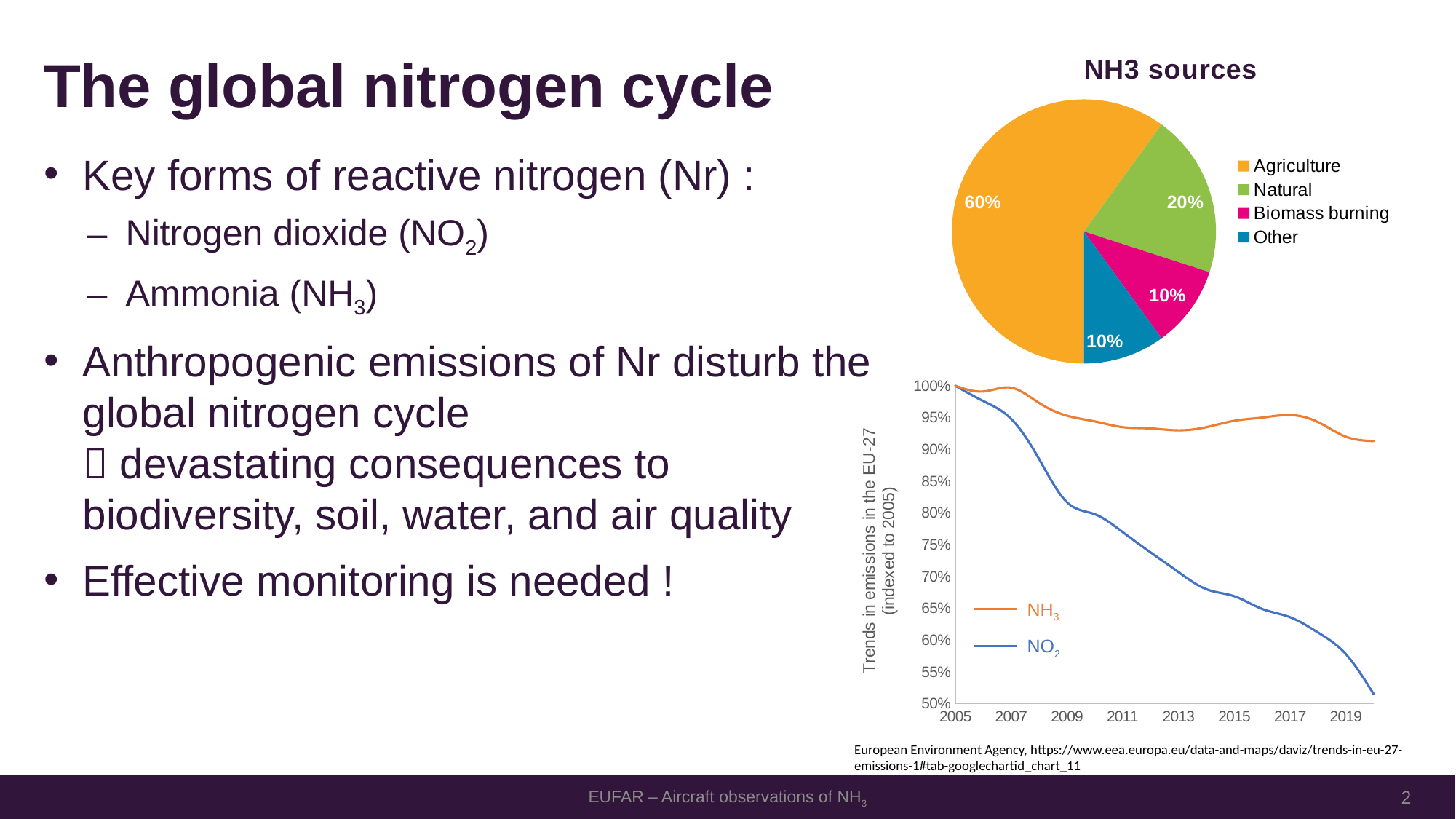
In the NH3 sources pie chart, what is the difference between the Agriculture and Natural shares? 40 percentage points In the NH3 sources pie chart, what share does Agriculture have? 60% In the NH3 sources pie chart, what share does Natural have? 20% What kind of chart is the chart titled NH3 sources? Pie chart In the NH3 sources pie chart, what share does Biomass burning have? 10% In the NH3 sources pie chart, how many slices are there? 4 In the line chart of trends in emissions in the EU-27, does the NO2 series rise or fall from 2005 to 2020? Fall In the line chart of trends in emissions in the EU-27, how many series does the legend list? 2 In the line chart of trends in emissions in the EU-27, which series is higher in 2015, NH3 or NO2? NH3 In the NH3 sources pie chart, which source has the largest share? Agriculture In the line chart of trends in emissions in the EU-27, is the NO2 value in 2009 greater or less than 90%? less In the NH3 sources pie chart, which is larger, Natural or Other? Natural